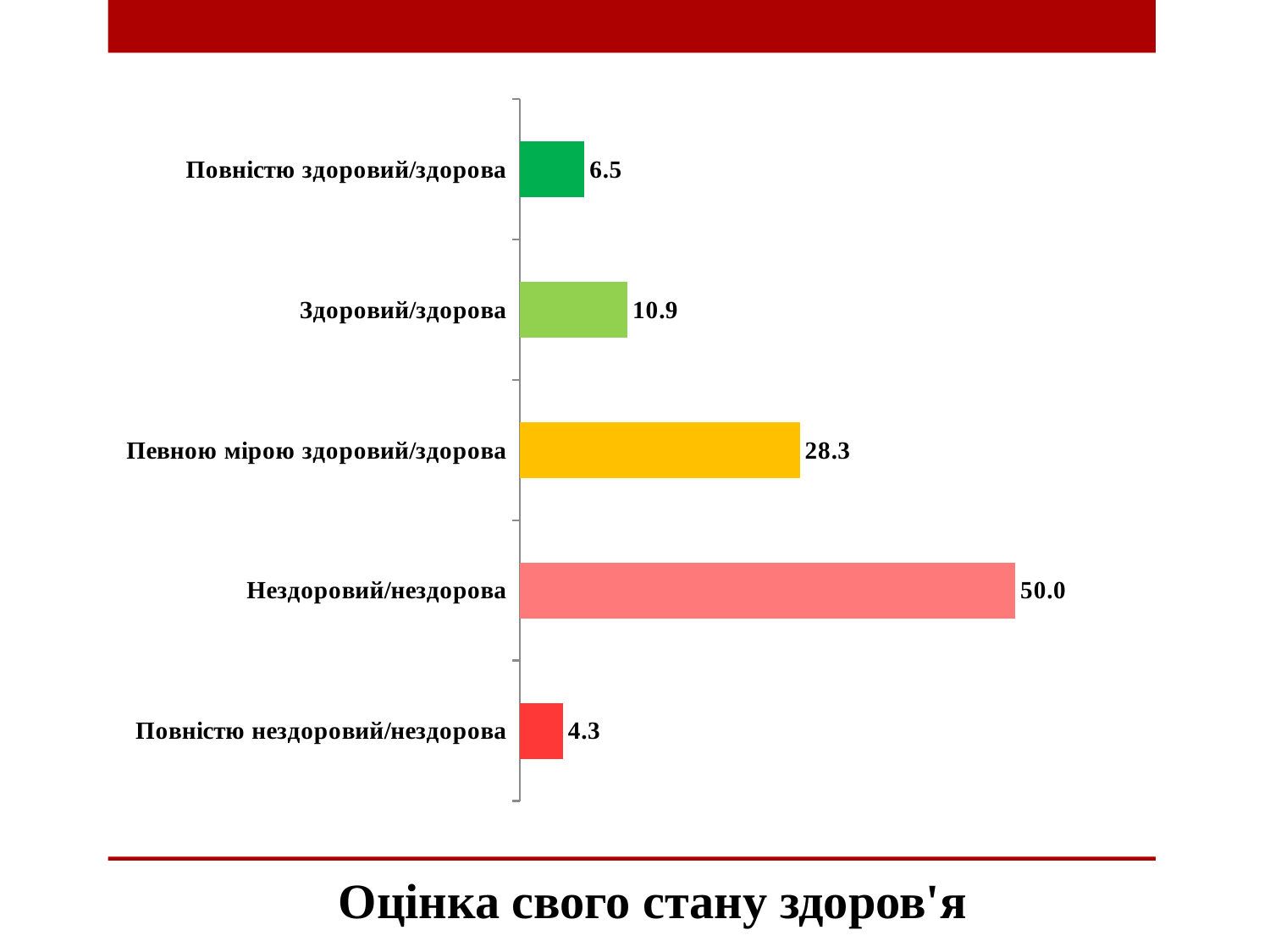
What is the value for Повністю здоровий/здорова? 6.5 What kind of chart is shown on the slide? Bar chart What is the value for Здоровий/здорова? 10.9 Which is larger, the value for Повністю здоровий/здорова or the value for Повністю нездоровий/нездорова? Повністю здоровий/здорова What is the difference between the values for Нездоровий/нездорова and Певною мірою здоровий/здорова? 21.7 How many categories are shown in the chart? 5 What is the title shown below the chart? Оцінка свого стану здоров'я What is the difference between the values for Здоровий/здорова and Повністю здоровий/здорова? 4.4 Which category has the lowest value? Повністю нездоровий/нездорова What is the value for Нездоровий/нездорова? 50.0 What is the value for Певною мірою здоровий/здорова? 28.3 Which category has the highest value? Нездоровий/нездорова